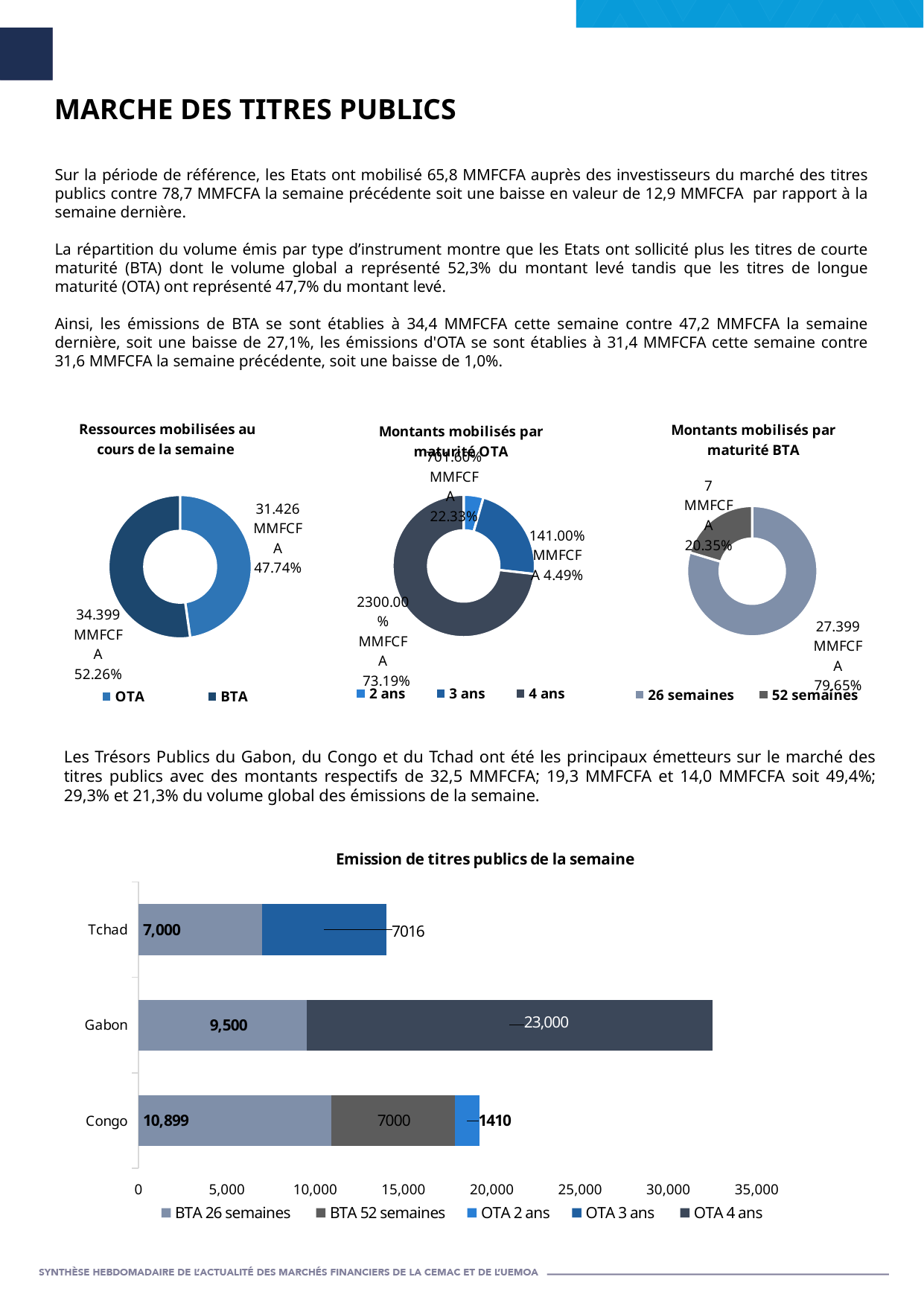
What kind of chart is 'Emission de titres publics de la semaine'? Stacked bar chart How many series does the legend of the chart 'Emission de titres publics de la semaine' list? 5 In the chart 'Ressources mobilisées au cours de la semaine', what share of the total does BTA represent? 52.26% In the chart 'Emission de titres publics de la semaine', what is the difference between the 'BTA 26 semaines' values for Congo and Gabon? 1,399 In the chart 'Montants mobilisés par maturité BTA', what amount is shown for '52 semaines'? 7 MMFCFA How many series does the legend of the chart 'Montants mobilisés par maturité OTA' list? 3 In the chart 'Montants mobilisés par maturité BTA', what share does '26 semaines' represent? 79.65% In the chart 'Emission de titres publics de la semaine', what is the total of the stacked bar for Congo? 19,309 In the chart 'Emission de titres publics de la semaine', what is the value of 'OTA 4 ans' for Gabon? 23,000 In the chart 'Ressources mobilisées au cours de la semaine', which category is larger, OTA or BTA? BTA In the chart 'Montants mobilisés par maturité OTA', which maturity has the largest slice? 4 ans In the chart 'Ressources mobilisées au cours de la semaine', what amount is shown for OTA? 31.426 MMFCFA